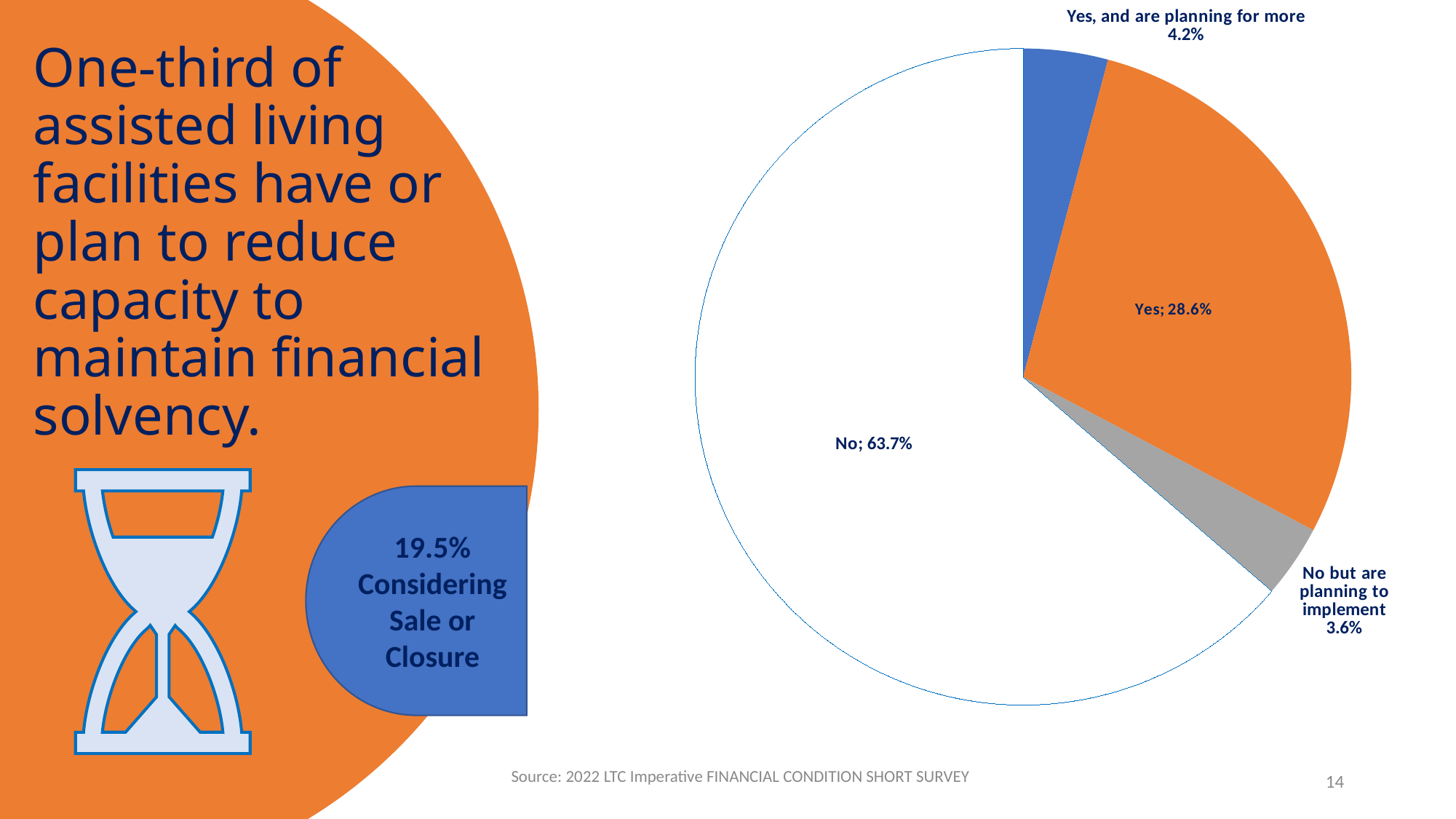
Which is larger, the "Yes, and are planning for more" slice or the "No but are planning to implement" slice? Yes, and are planning for more What colour is the "No" slice of the pie? white What share of the pie is labelled "No"? 63.7% What share of the pie is labelled "Yes, and are planning for more"? 4.2% What is the combined share of the "Yes" and "Yes, and are planning for more" slices? 32.8% How many slices does the pie chart have? 4 What share of the pie is labelled "No but are planning to implement"? 3.6% Which slice of the pie is the smallest? No but are planning to implement What is the difference between the "No" slice and the "Yes" slice? 35.1% What kind of chart is shown on the slide? pie chart Which slice of the pie is the largest? No What share of the pie is labelled "Yes"? 28.6%